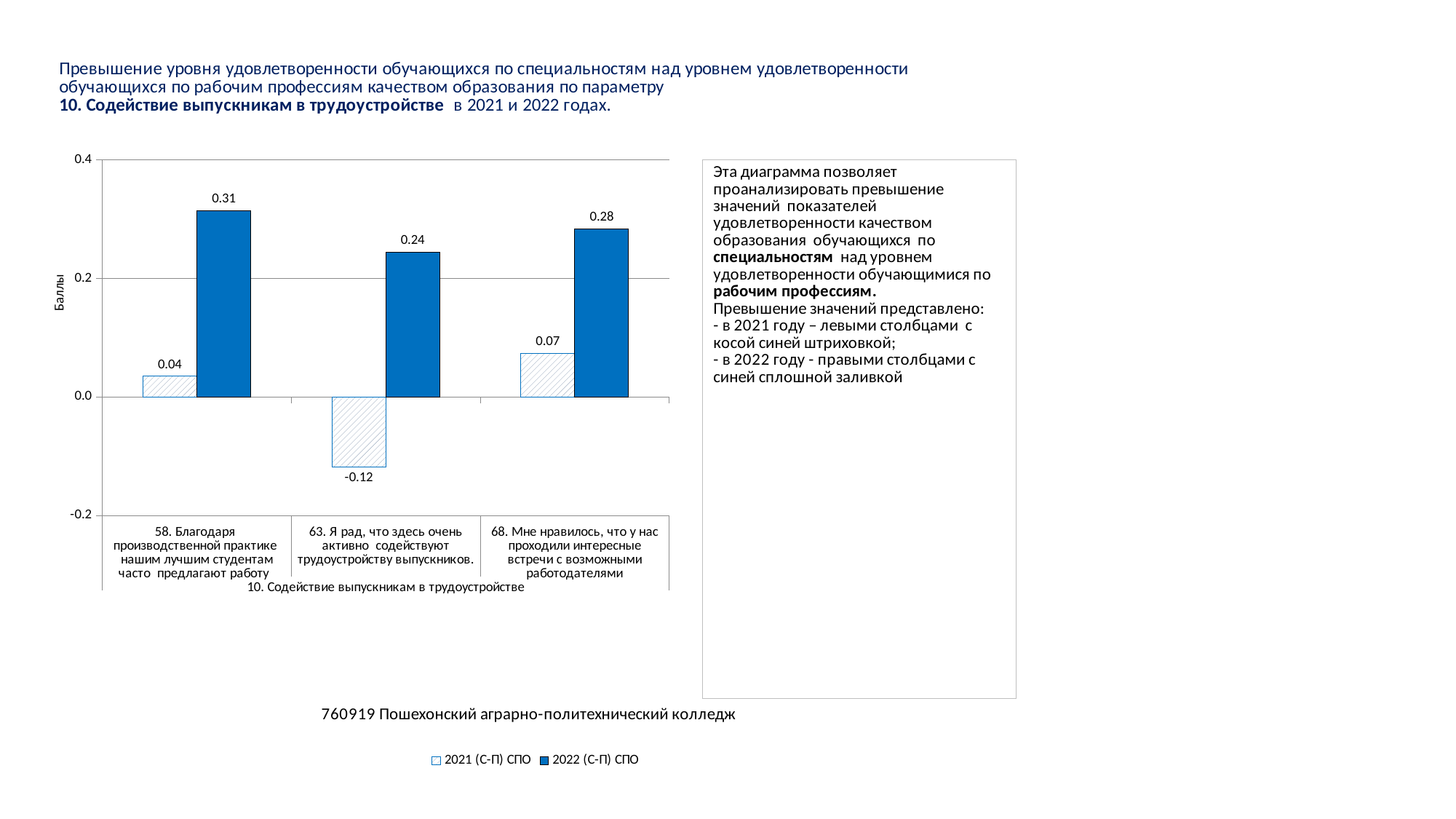
What is the difference between the 2022 and 2021 values for category 63? 0.36 What is the difference between the 2022 and 2021 values for category 58? 0.27 What is the value for the 2021 (С-П) СПО series for category 68 ("Мне нравилось, что у нас проходили интересные встречи с возможными работодателями")? 0.07 Which category has the lowest value in the 2021 (С-П) СПО series? 63. Я рад, что здесь очень активно содействуют трудоустройству выпускников. How many series does the chart legend list? 2 What is the value for the 2021 (С-П) СПО series for category 63 ("Я рад, что здесь очень активно содействуют трудоустройству выпускников")? -0.12 What type of chart is shown on the slide? Bar chart What is the value for the 2022 (С-П) СПО series for category 58 ("Благодаря производственной практике нашим лучшим студентам часто предлагают работу")? 0.31 Is the 2022 (С-П) СПО value for category 68 greater or less than 0.2? greater Which is larger: the 2022 value for category 63 or the 2022 value for category 68? 2022 value for category 68 Which category has the highest value in the 2022 (С-П) СПО series? 58. Благодаря производственной практике нашим лучшим студентам часто предлагают работу How many categories are shown on the x axis of the chart? 3